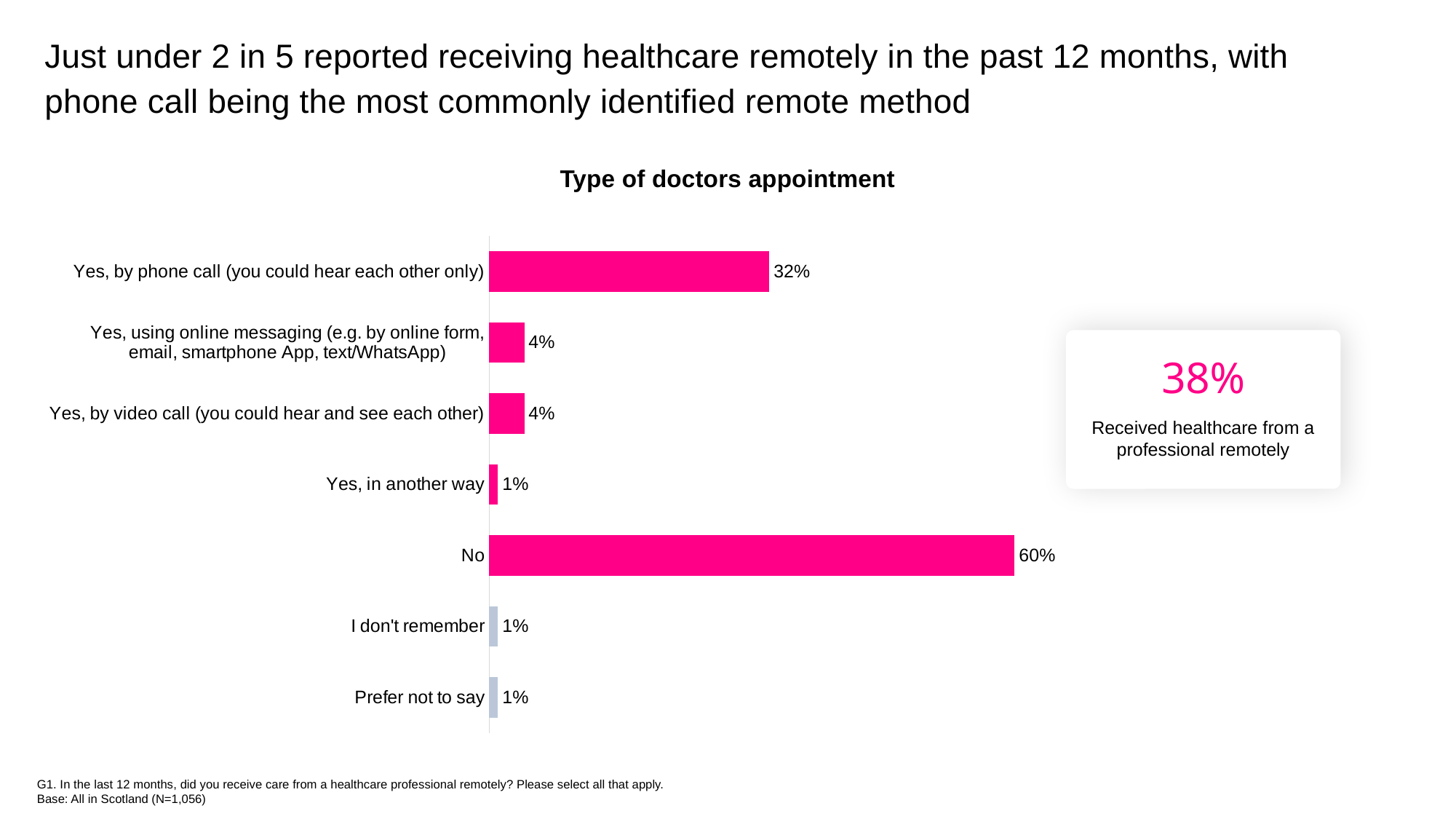
What is the value for 'Yes, in another way'? 1% What percentage reported receiving healthcare by video call? 4% What is the value for the 'No' category? 60% What type of chart is shown on the slide? Bar chart How many categories are shown in the chart? 7 What is the title of the chart? Type of doctors appointment What is the difference between the 'No' value and the 'Yes, by phone call' value? 28 percentage points Which is larger: the value for 'Yes, by phone call' or the value for 'Yes, using online messaging'? Yes, by phone call Which category has the highest value? No What percentage of respondents reported receiving healthcare by phone call? 32% What percentage is shown in the callout box as having received healthcare from a professional remotely? 38% What is the difference between the 'Yes, using online messaging' value and the 'Yes, in another way' value? 3 percentage points